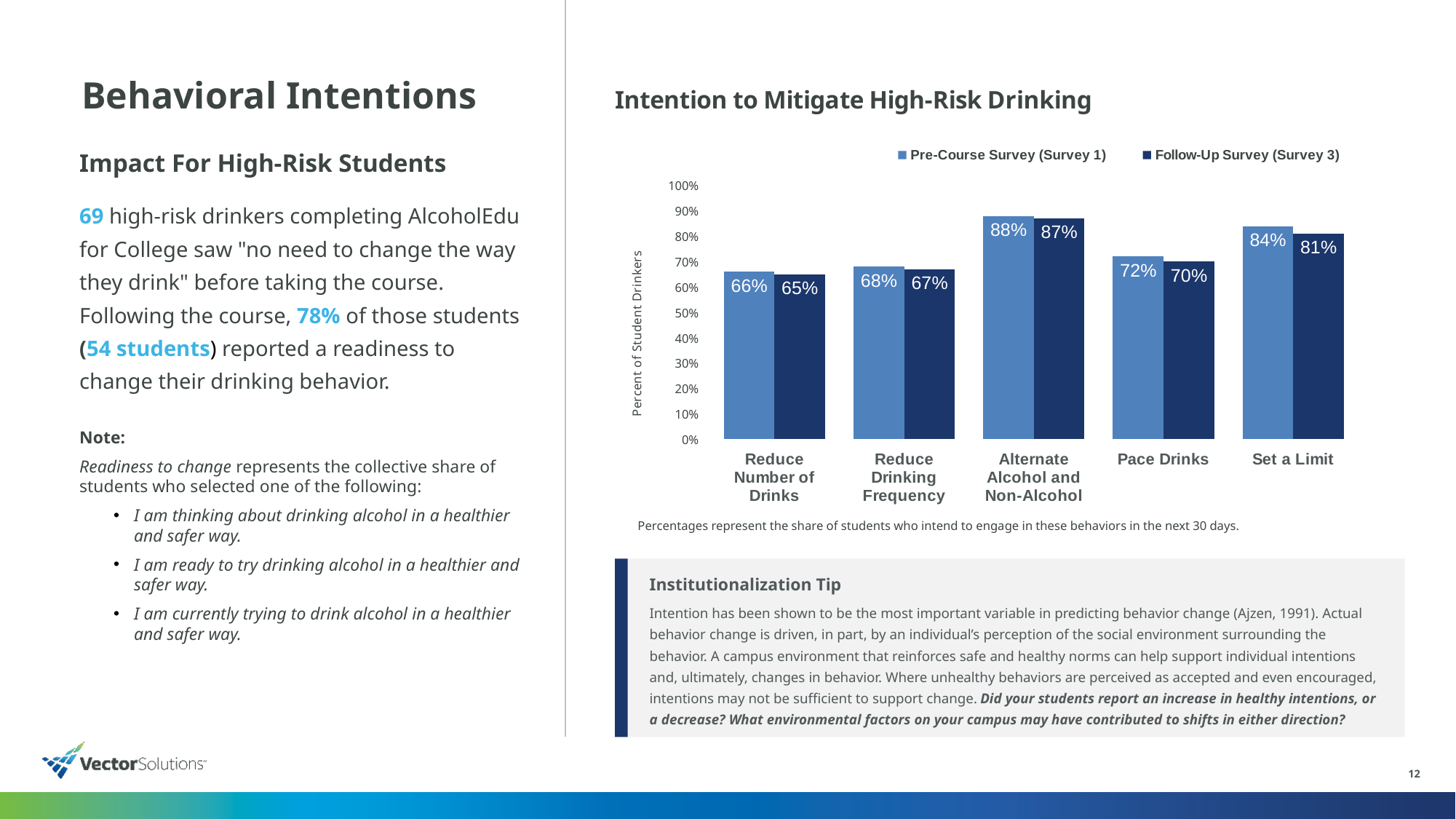
What is the Follow-Up Survey (Survey 3) value for Pace Drinks? 70% How many categories are shown on the x axis of the chart? 5 How many series does the chart legend list? 2 What is the Follow-Up Survey (Survey 3) value for Set a Limit? 81% What is the difference between the Pre-Course Survey values for Alternate Alcohol and Non-Alcohol and Reduce Drinking Frequency? 20% What is the Pre-Course Survey (Survey 1) value for Reduce Number of Drinks? 66% Which is larger: the Pre-Course Survey value for Pace Drinks or the Follow-Up Survey value for Pace Drinks? Pre-Course Survey (Survey 1) Which category has the highest Pre-Course Survey (Survey 1) value? Alternate Alcohol and Non-Alcohol What is the difference between the Pre-Course Survey and Follow-Up Survey values for Set a Limit? 3% What is the title of the chart? Intention to Mitigate High-Risk Drinking Which category has the lowest Follow-Up Survey (Survey 3) value? Reduce Number of Drinks What kind of chart is shown on the slide? Bar chart